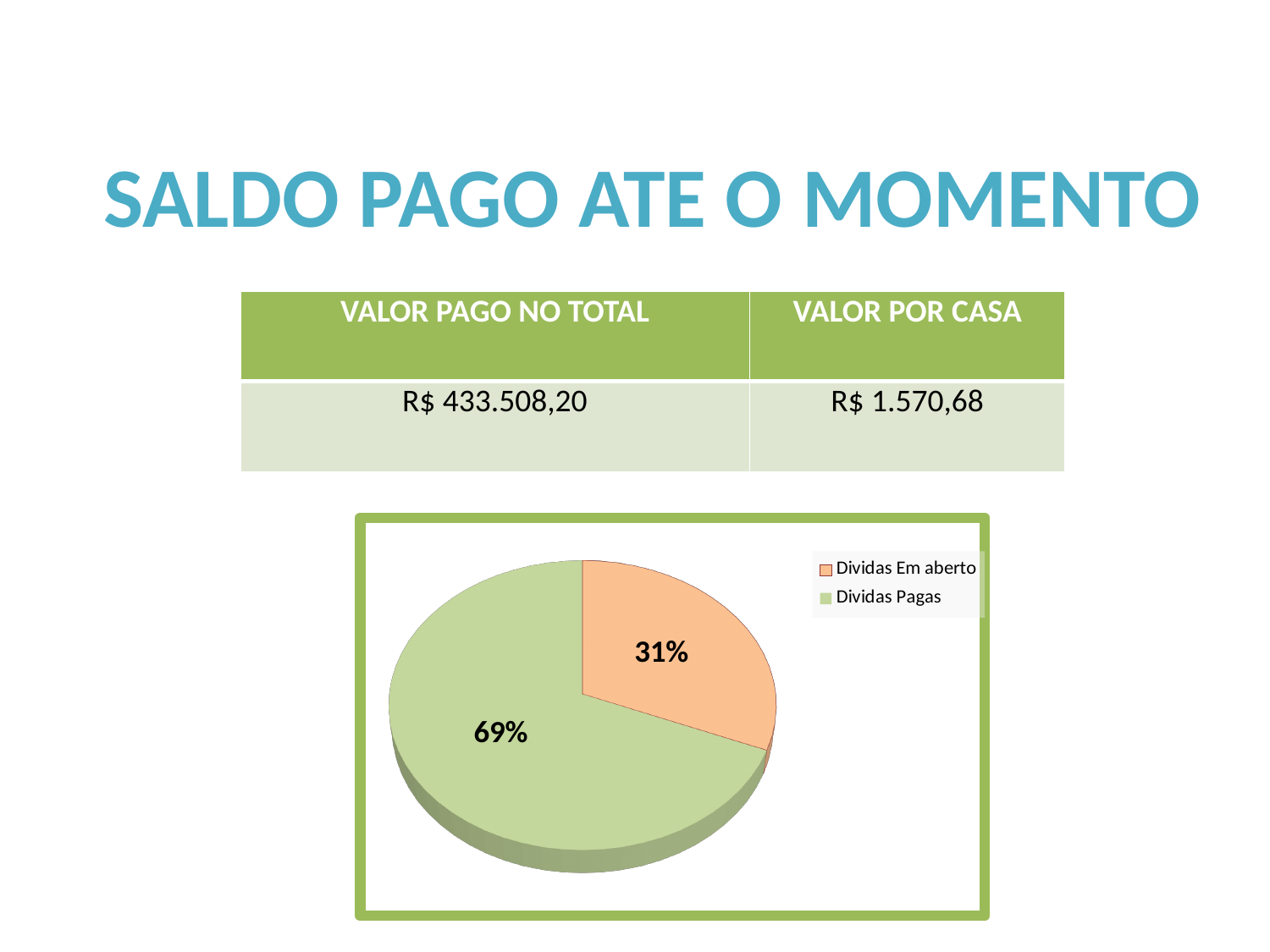
What kind of chart is shown on the slide? pie chart Which slice of the pie is the largest? Dividas Pagas What colour is the Dividas Em aberto slice? orange What share of the pie does Dividas Pagas represent? 69% What colour is the Dividas Pagas slice? green What share of the pie does Dividas Em aberto represent? 31% Which slice of the pie is the smallest? Dividas Em aberto How many slices does the pie chart have? 2 Is the share for Dividas Em aberto greater or less than 50%? less How many entries does the legend list? 2 Which is larger, Dividas Pagas or Dividas Em aberto? Dividas Pagas What is the difference in percentage points between Dividas Pagas and Dividas Em aberto? 38